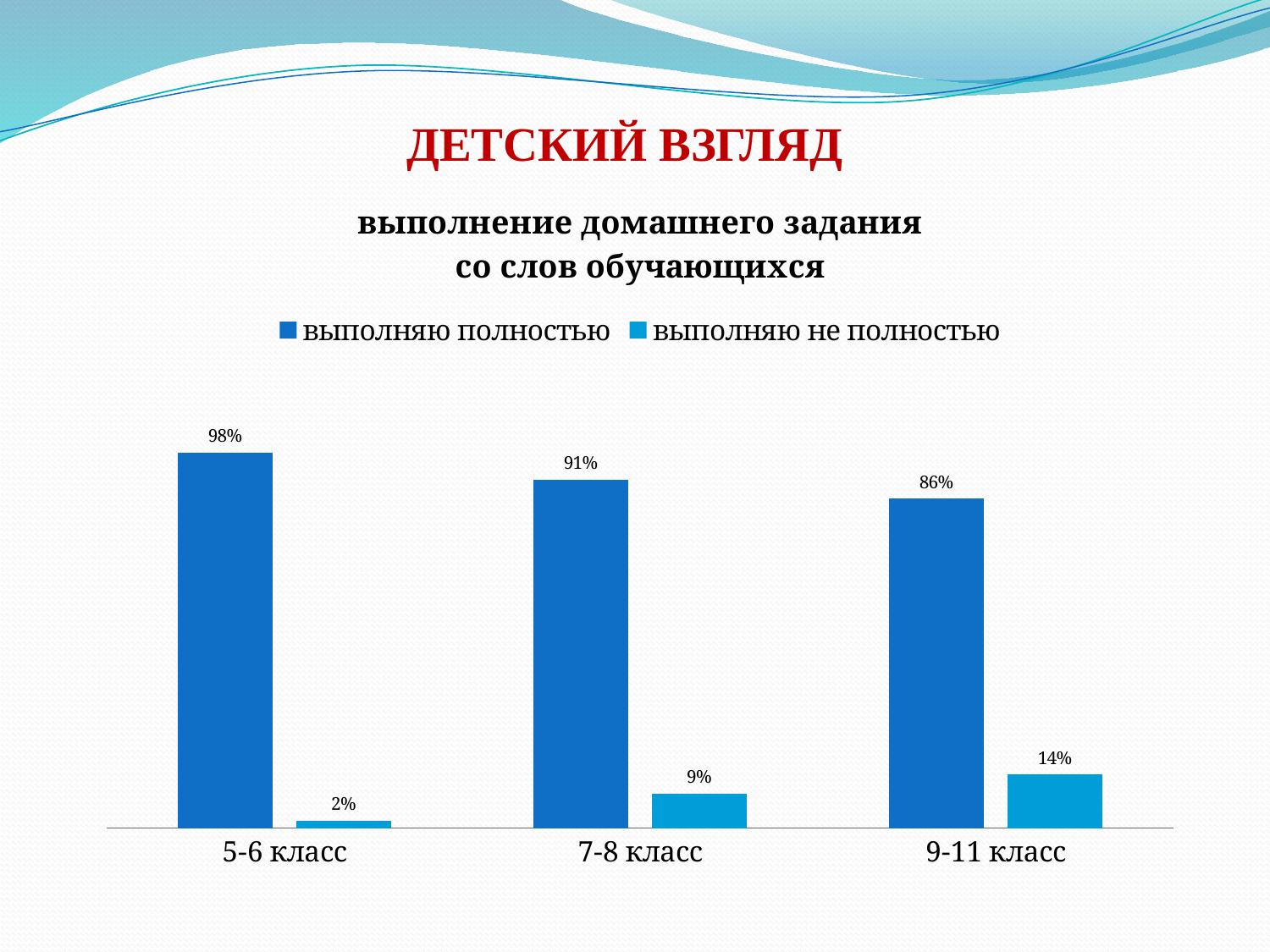
What kind of chart is shown on the slide? bar chart What is the value for "выполняю полностью" for 5-6 класс? 98% How many categories are shown on the x axis? 3 How many series does the legend list? 2 What is the title of the chart? выполнение домашнего задания со слов обучающихся What is the value for "выполняю не полностью" for 9-11 класс? 14% Which is larger: "выполняю не полностью" for 5-6 класс or for 7-8 класс? 7-8 класс What is the value for "выполняю полностью" for 7-8 класс? 91% Do the values for "выполняю полностью" rise or fall from 5-6 класс to 9-11 класс? fall Which category has the highest value for "выполняю не полностью"? 9-11 класс Which category has the lowest value for "выполняю полностью"? 9-11 класс What is the difference between "выполняю полностью" and "выполняю не полностью" for 7-8 класс? 82%